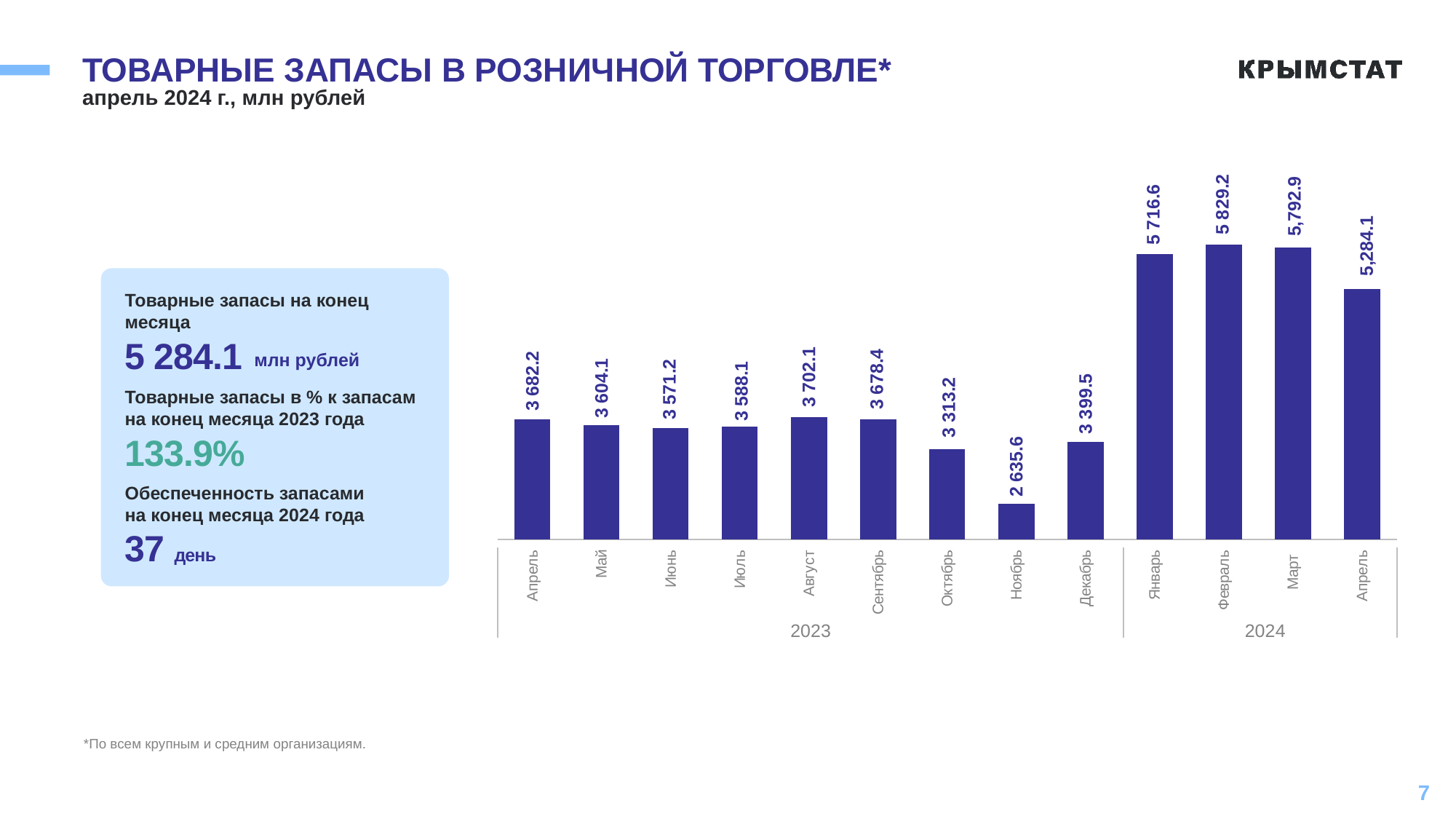
Which month has the highest value? Февраль 2024 What is the title of the slide's chart? ТОВАРНЫЕ ЗАПАСЫ В РОЗНИЧНОЙ ТОРГОВЛЕ* What is the value for Ноябрь 2023? 2 635.6 How many months are plotted in the chart? 13 What kind of chart is shown on the slide? Bar chart What is the value for Февраль 2024? 5 829.2 What is the value for Август 2023? 3 702.1 What is the difference between the values for Январь 2024 and Декабрь 2023? 2 317.1 Which is larger, the value for Апрель 2023 or the value for Сентябрь 2023? Апрель 2023 Do the values rise or fall from Февраль 2024 to Апрель 2024? Fall Which month has the lowest value? Ноябрь 2023 What is the value for Апрель 2024? 5,284.1